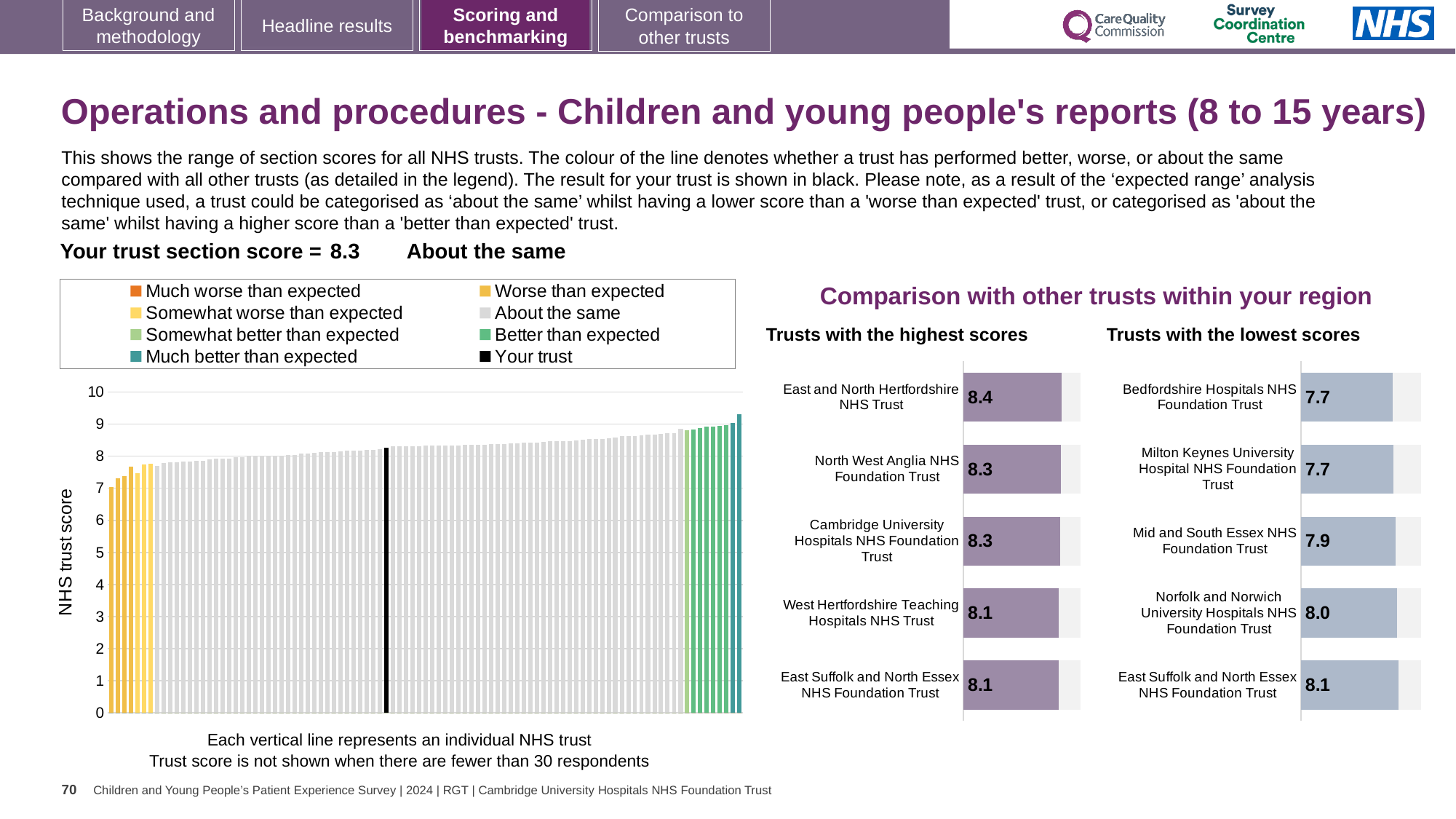
In the 'Trusts with the highest scores' chart, which trust has the highest score? East and North Hertfordshire NHS Trust In the 'Trusts with the lowest scores' chart, which has the larger score: Norfolk and Norwich University Hospitals NHS Foundation Trust or Milton Keynes University Hospital NHS Foundation Trust? Norfolk and Norwich University Hospitals NHS Foundation Trust In the large chart on the left, is the value of the lowest bar greater or less than 8? less How many entries does the legend of the large chart on the left list? 8 What kind of chart is the large chart on the left showing NHS trust scores? Bar chart In the 'Trusts with the highest scores' chart, how many trusts are shown? 5 In the 'Trusts with the lowest scores' chart, what is the score for Mid and South Essex NHS Foundation Trust? 7.9 In the 'Trusts with the lowest scores' chart, what is the difference between the scores of East Suffolk and North Essex NHS Foundation Trust and Bedfordshire Hospitals NHS Foundation Trust? 0.4 In the 'Trusts with the highest scores' chart, what is the difference between the scores of East and North Hertfordshire NHS Trust and West Hertfordshire Teaching Hospitals NHS Trust? 0.3 In the 'Trusts with the lowest scores' chart, which trust has the highest score? East Suffolk and North Essex NHS Foundation Trust In the large chart on the left, do the trust scores rise or fall from left to right? Rise In the 'Trusts with the highest scores' chart, what is the score for East and North Hertfordshire NHS Trust? 8.4